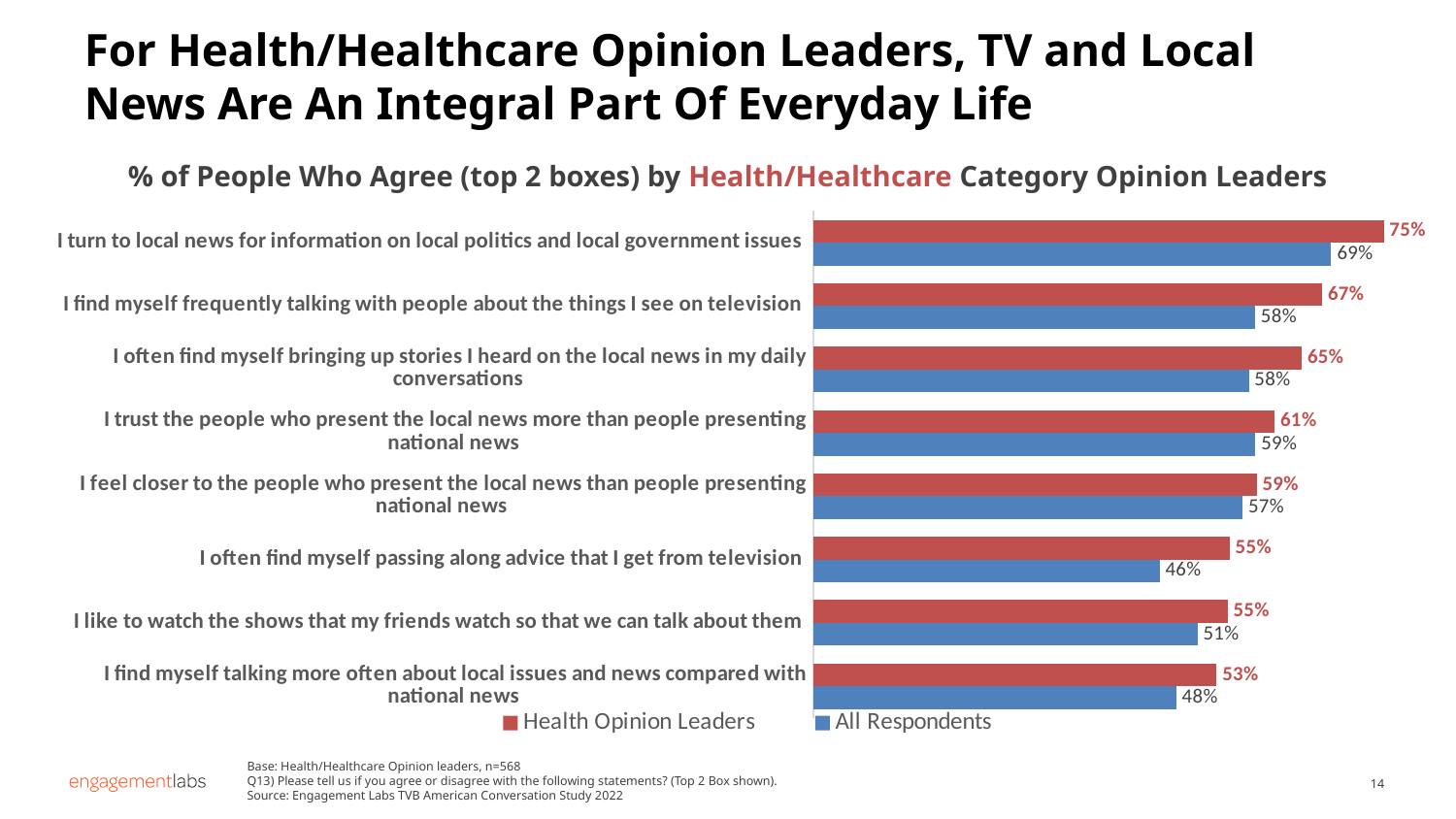
What percentage of All Respondents agree with "I find myself talking more often about local issues and news compared with national news"? 48% Which statement has the highest agreement among Health Opinion Leaders? I turn to local news for information on local politics and local government issues For "I trust the people who present the local news more than people presenting national news", which group has the higher value: Health Opinion Leaders or All Respondents? Health Opinion Leaders What is the difference between Health Opinion Leaders and All Respondents for "I like to watch the shows that my friends watch so that we can talk about them"? 4 percentage points What percentage of All Respondents agree with "I often find myself passing along advice that I get from television"? 46% What percentage of Health Opinion Leaders agree with "I turn to local news for information on local politics and local government issues"? 75% What is the difference between Health Opinion Leaders and All Respondents for "I find myself frequently talking with people about the things I see on television"? 9 percentage points Which statement has the lowest agreement among All Respondents? I often find myself passing along advice that I get from television What colour represents Health Opinion Leaders in the chart? Red What kind of chart is shown on the slide? Bar chart How many statements are shown in the chart? 8 How many series does the legend list? 2